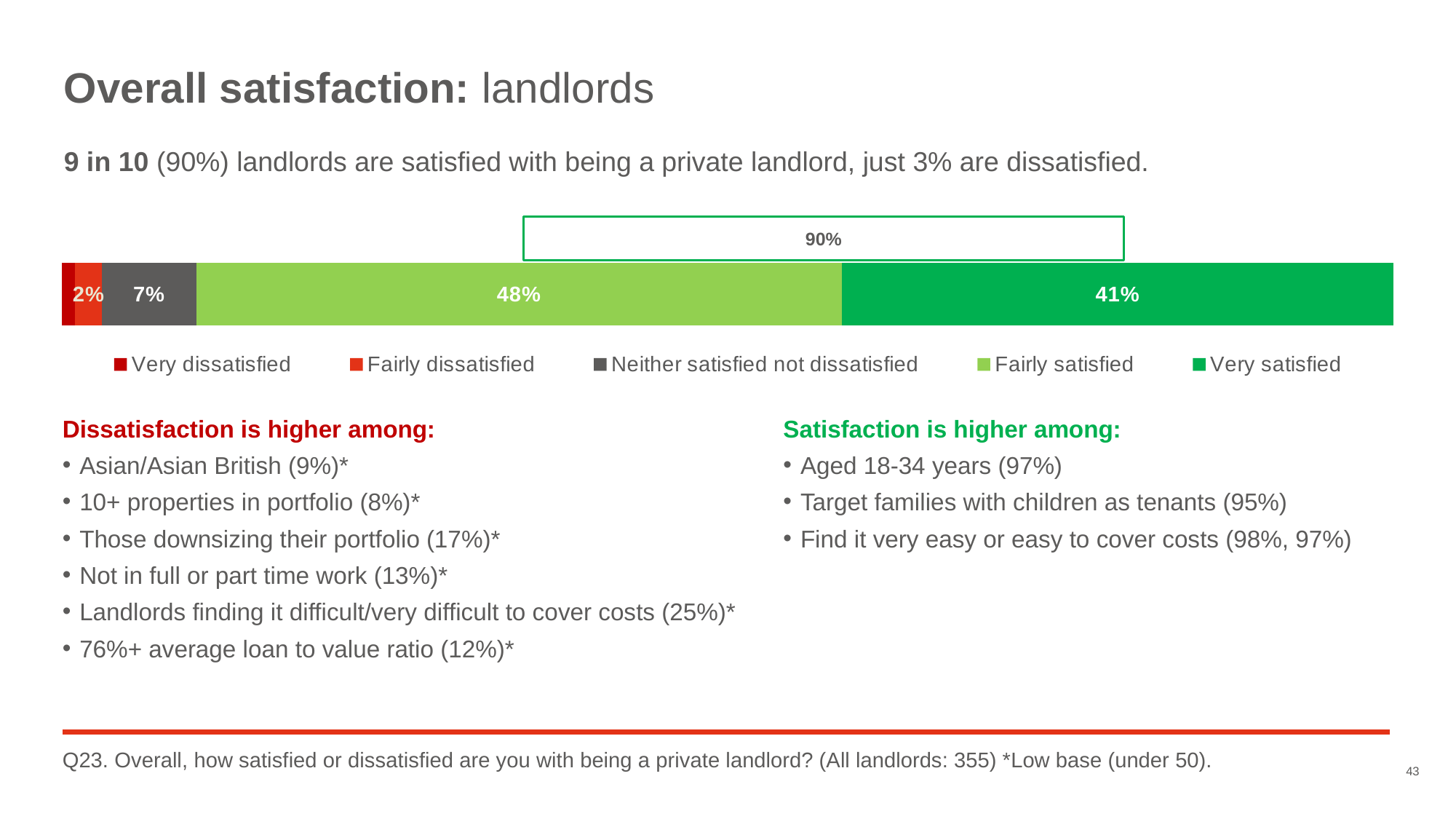
Which response category has the smallest share of the bar? Very dissatisfied What kind of chart is shown on the slide? Stacked bar chart What percentage is shown in the bracket above the satisfied segments of the bar? 90% How many percentage points higher is the fairly satisfied share than the very satisfied share? 7 What percentage of landlords are fairly dissatisfied? 2% What percentage of landlords are fairly satisfied? 48% How many response categories does the legend list? 5 Which is larger: the fairly satisfied share or the very satisfied share? Fairly satisfied Which response category has the largest share of the bar? Fairly satisfied What colour is used for the very satisfied segment? Dark green What percentage of landlords are neither satisfied nor dissatisfied? 7% What percentage of landlords are very satisfied? 41%